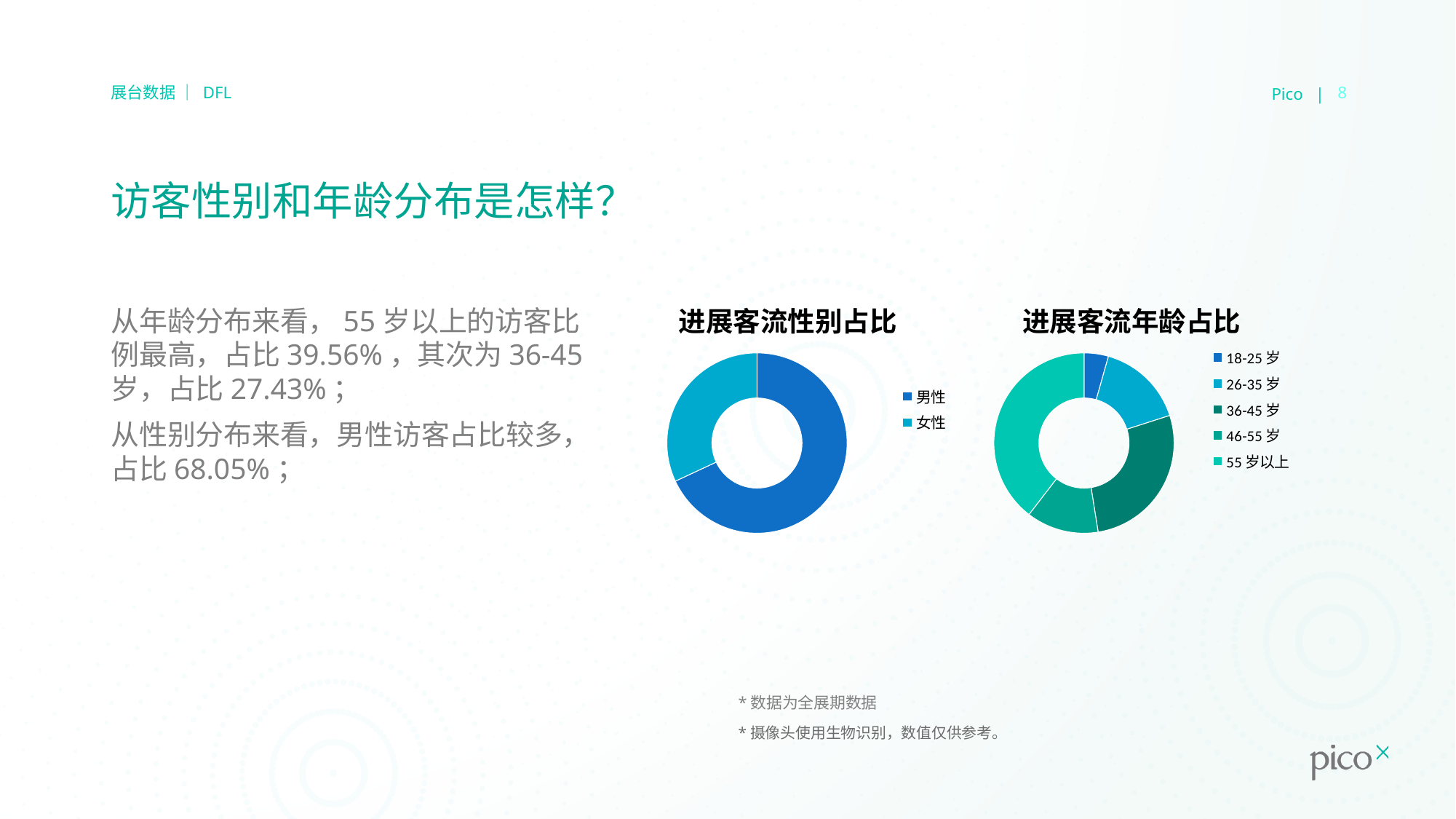
What is the title of the left chart on the slide? 进展客流性别占比 In the 进展客流年龄占比 chart, which age group has the largest share? 55 岁以上 According to the slide, what share of visitors in the 进展客流性别占比 chart is 男性? 68.05% What kind of chart is the 进展客流性别占比 chart? doughnut chart How many entries does the legend of the 进展客流性别占比 chart list? 2 In the 进展客流年龄占比 chart, which age group has the smallest share? 18-25 岁 In the 进展客流年龄占比 chart, which slice is larger: 26-35 岁 or 36-45 岁? 36-45 岁 In the 进展客流年龄占比 chart, which slice is larger: 46-55 岁 or 18-25 岁? 46-55 岁 According to the slide, what share of visitors in the 进展客流年龄占比 chart is 55 岁以上? 39.56% In the 进展客流性别占比 chart, which gender has the larger share? 男性 How many age categories does the 进展客流年龄占比 chart show? 5 According to the slide, what share of visitors in the 进展客流年龄占比 chart is 36-45 岁? 27.43%